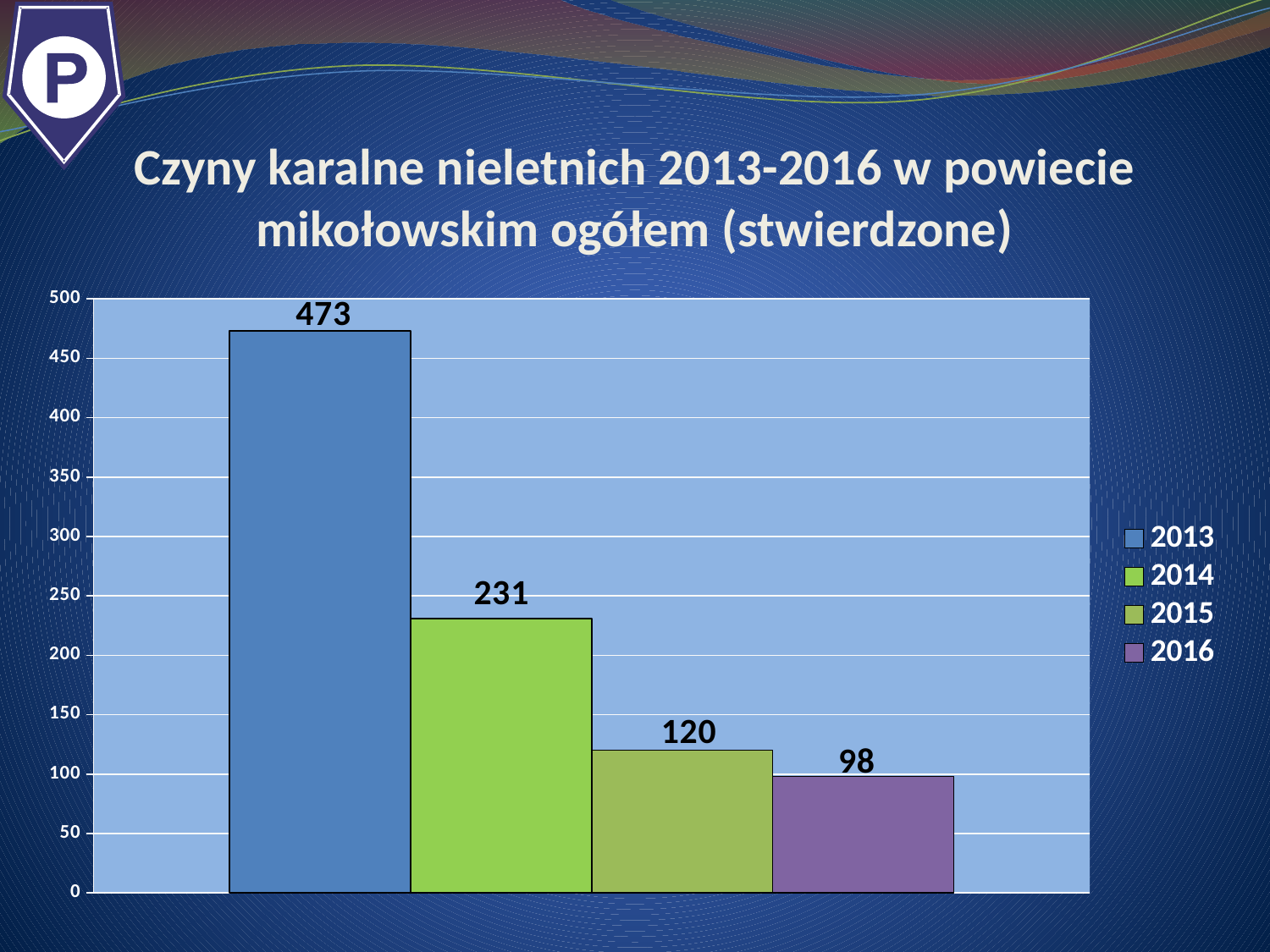
Which year has the lowest value? 2016 What is the value for 2016? 98 What is the value for 2015? 120 What is the value for 2014? 231 What is the difference between the values for 2013 and 2014? 242 Which year has the highest value? 2013 Which is larger, the value for 2014 or the value for 2015? 2014 Do the values rise or fall from 2013 to 2016? fall How many series does the legend list? 4 What is the difference between the values for 2015 and 2016? 22 What is the value for 2013? 473 What kind of chart is shown on the slide? bar chart